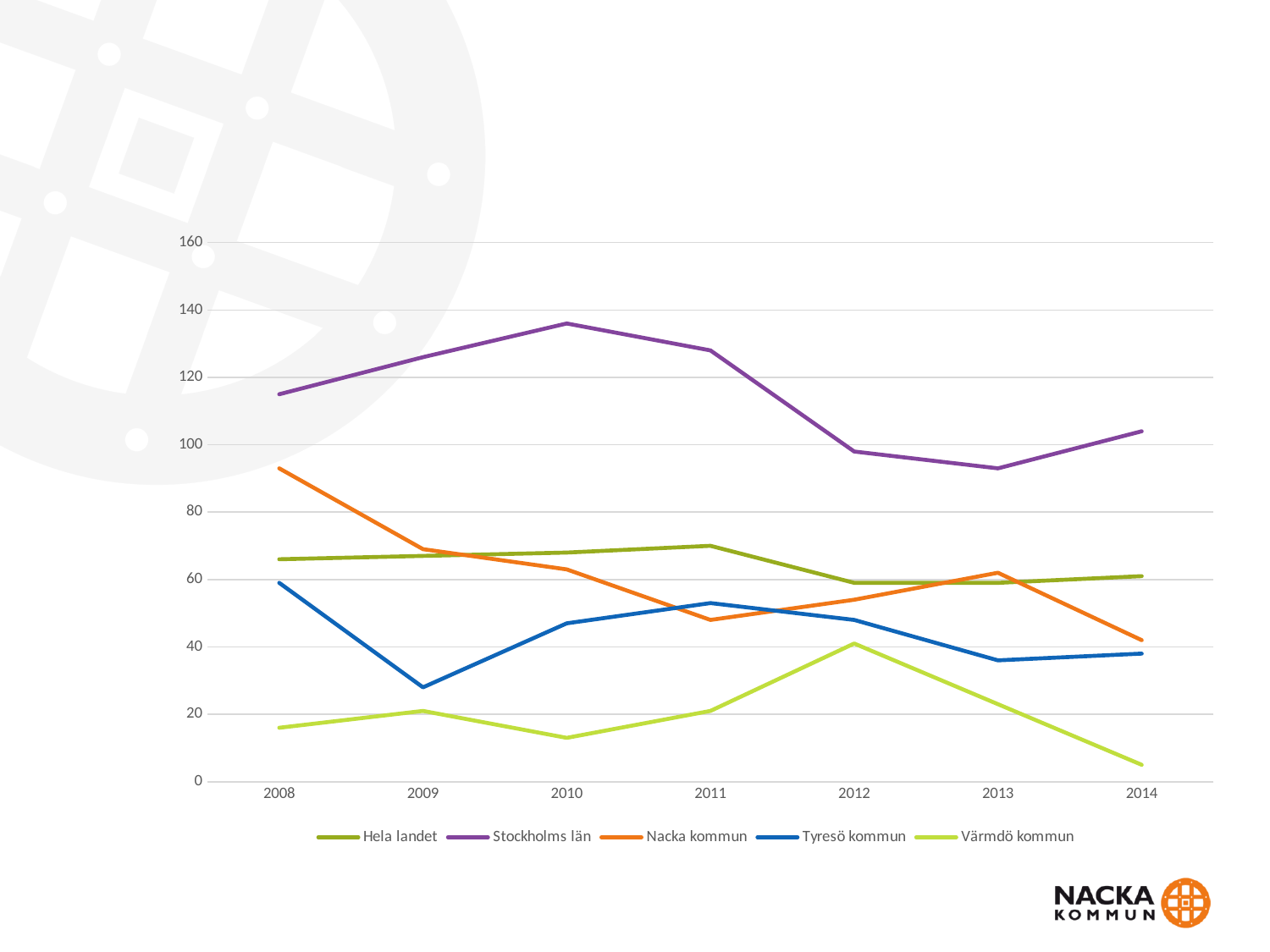
Which series has the lowest value in 2014? Värmdö kommun What colour is the line for Nacka kommun? orange In which year does Stockholms län reach its highest value? 2010 How many years are shown on the x axis? 7 Does the value for Värmdö kommun rise or fall from 2012 to 2014? fall What kind of chart is shown on the slide? line chart Is the value for Stockholms län in 2010 greater or less than 120? greater In 2008, which is larger: the value for Nacka kommun or the value for Tyresö kommun? Nacka kommun Is the value for Värmdö kommun in 2014 greater or less than 20? less How many series does the legend list? 5 Which series has the highest value in 2010? Stockholms län In which year does Tyresö kommun reach its lowest value? 2009